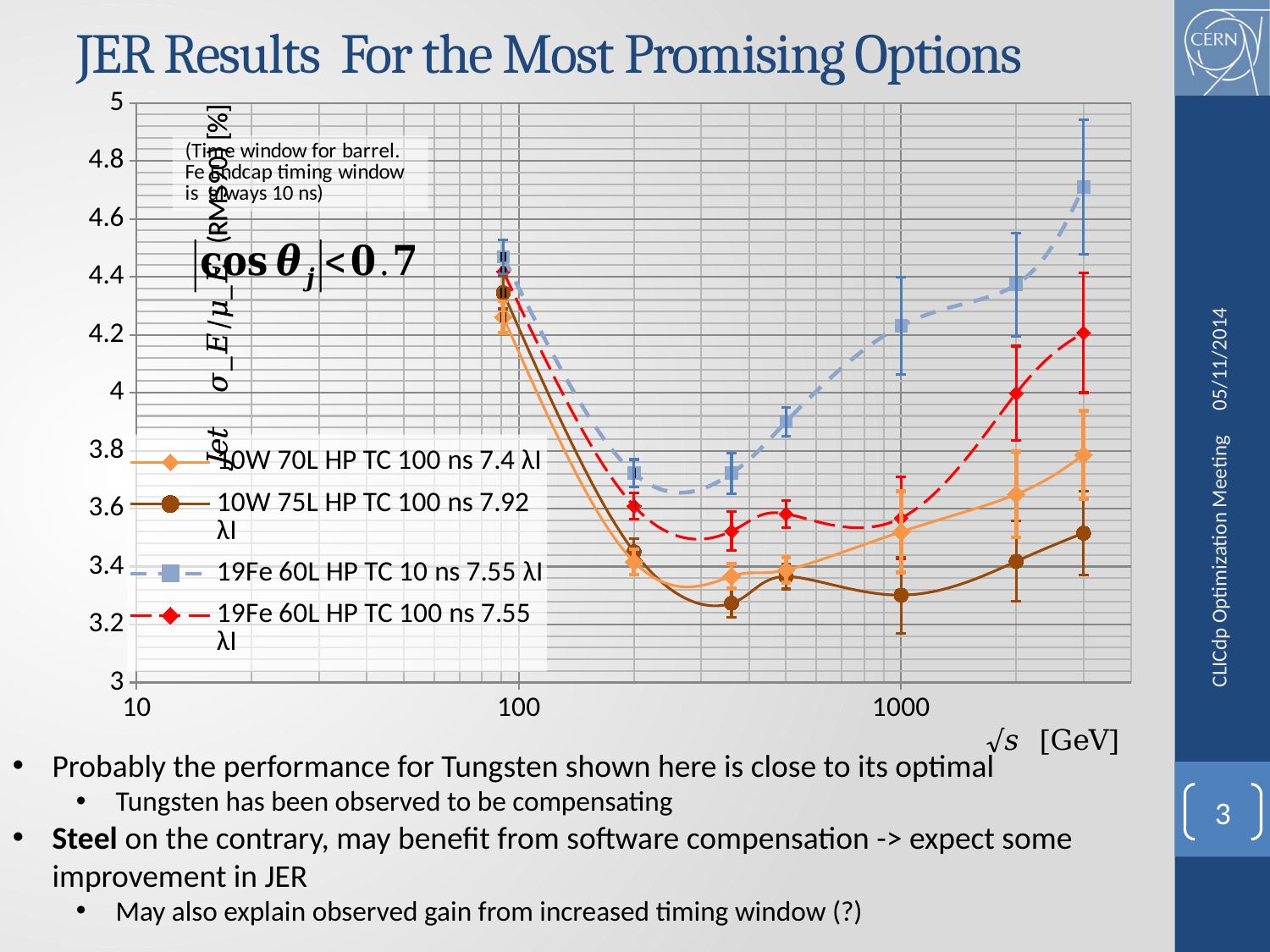
At the rightmost data point, which series has the highest value? 19Fe 60L HP TC 10 ns 7.55 λI At the rightmost data point, which series has the lowest value? 10W 75L HP TC 100 ns 7.92 λI Is the value of the 19Fe 60L HP TC 10 ns 7.55 λI series at 1000 GeV greater or less than 4? greater Which series is drawn with red diamond markers? 19Fe 60L HP TC 100 ns 7.55 λI At 1000 GeV, which is larger: the 19Fe 60L HP TC 10 ns 7.55 λI series or the 10W 75L HP TC 100 ns 7.92 λI series? 19Fe 60L HP TC 10 ns 7.55 λI What is the title of the chart? JER Results For the Most Promising Options Is the value of the 19Fe 60L HP TC 10 ns 7.55 λI series at its rightmost point greater or less than 4.4? greater Is the value of the 10W 75L HP TC 100 ns 7.92 λI series at its rightmost point greater or less than 3.8? less Between 1000 GeV and the rightmost point, does the 19Fe 60L HP TC 100 ns 7.55 λI series rise or fall? rise How many series does the legend list? 4 What kind of chart is shown on the slide? line chart